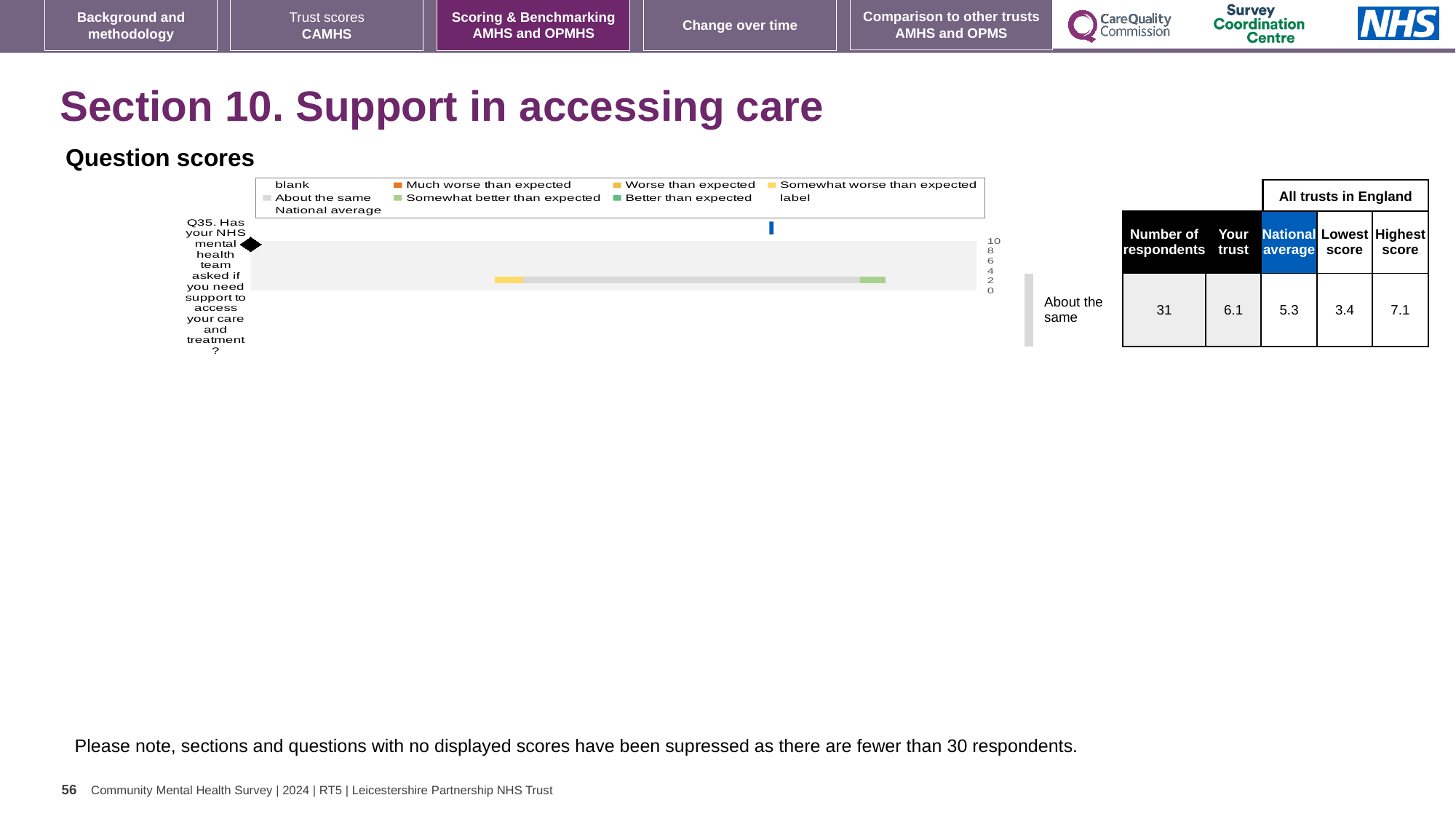
How many questions are plotted in the Question scores chart? 1 Which benchmark category is Q35 assigned to on this slide? About the same What is the lowest score among all trusts in England for Q35? 3.4 What is the 'Your trust' score for Q35? 6.1 What is the difference between the highest and lowest trust scores for Q35? 3.7 What is the highest score among all trusts in England for Q35? 7.1 What is the national average score for Q35? 5.3 What is the title of the chart on this slide? Question scores How many respondents answered Q35? 31 Which is larger for Q35: the trust's score or the national average? Your trust (6.1) What kind of chart is shown under 'Question scores'? bar chart By how much does the trust's score for Q35 exceed the national average? 0.8